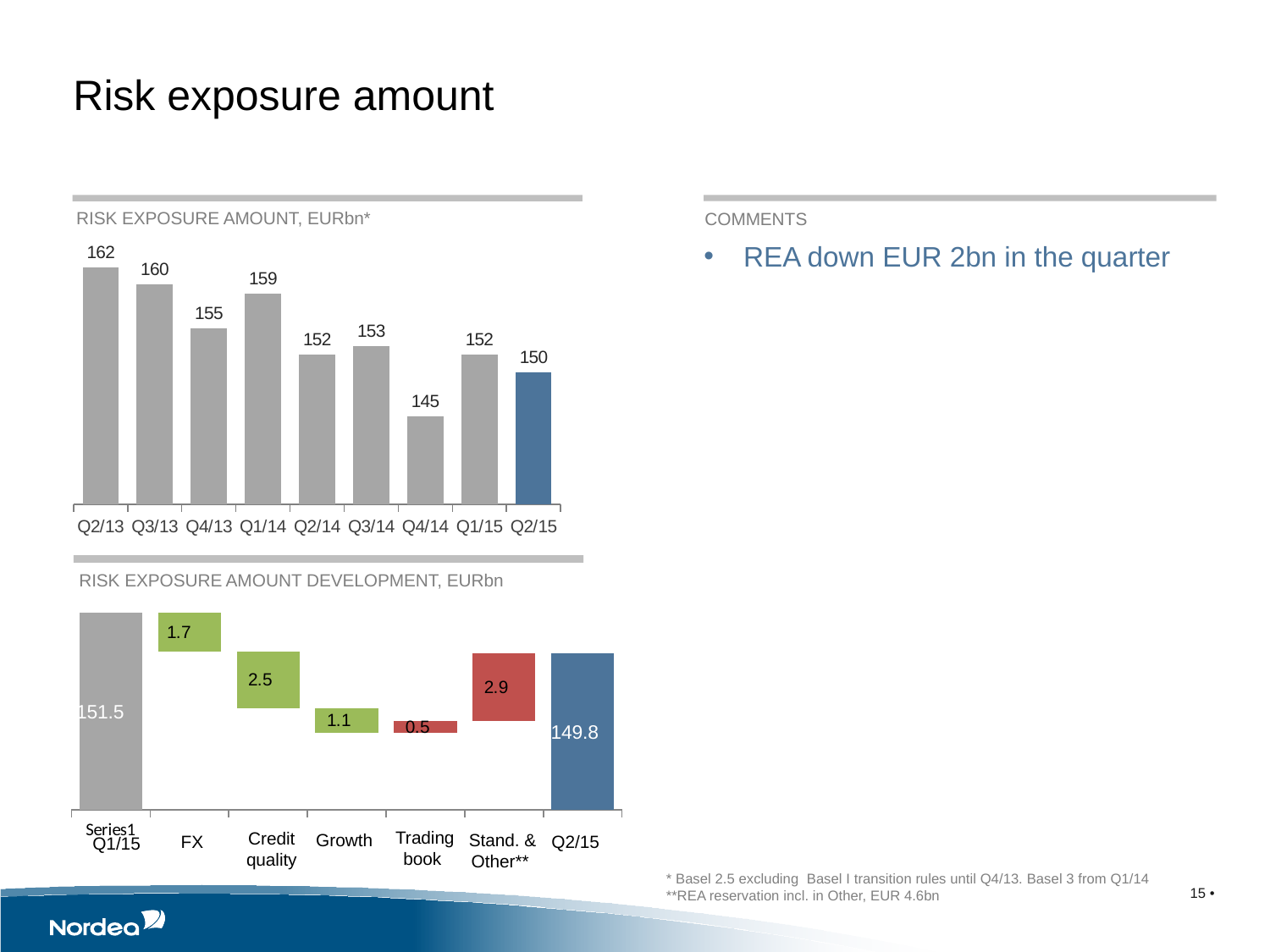
How many quarters are shown in the 'RISK EXPOSURE AMOUNT, EURbn*' chart? 9 In the 'RISK EXPOSURE AMOUNT DEVELOPMENT, EURbn' chart, what is the value for Credit quality? 2.5 In the 'RISK EXPOSURE AMOUNT, EURbn*' chart, what is the value for Q2/15? 150 What type of chart is the 'RISK EXPOSURE AMOUNT, EURbn*' chart? Bar chart In the 'RISK EXPOSURE AMOUNT, EURbn*' chart, which is larger, the value for Q1/14 or the value for Q4/13? Q1/14 In the 'RISK EXPOSURE AMOUNT, EURbn*' chart, which quarter has the lowest value? Q4/14 In the 'RISK EXPOSURE AMOUNT, EURbn*' chart, what is the value for Q4/14? 145 In the 'RISK EXPOSURE AMOUNT, EURbn*' chart, what is the difference between the Q2/13 value and the Q2/15 value? 12 In the 'RISK EXPOSURE AMOUNT DEVELOPMENT, EURbn' chart, what is the difference between the Q1/15 value and the Q2/15 value? 1.7 In the 'RISK EXPOSURE AMOUNT DEVELOPMENT, EURbn' chart, what is the value for Q1/15? 151.5 In the 'RISK EXPOSURE AMOUNT, EURbn*' chart, which quarter has the highest value? Q2/13 In the 'RISK EXPOSURE AMOUNT DEVELOPMENT, EURbn' chart, what is the value for Stand. & Other**? 2.9